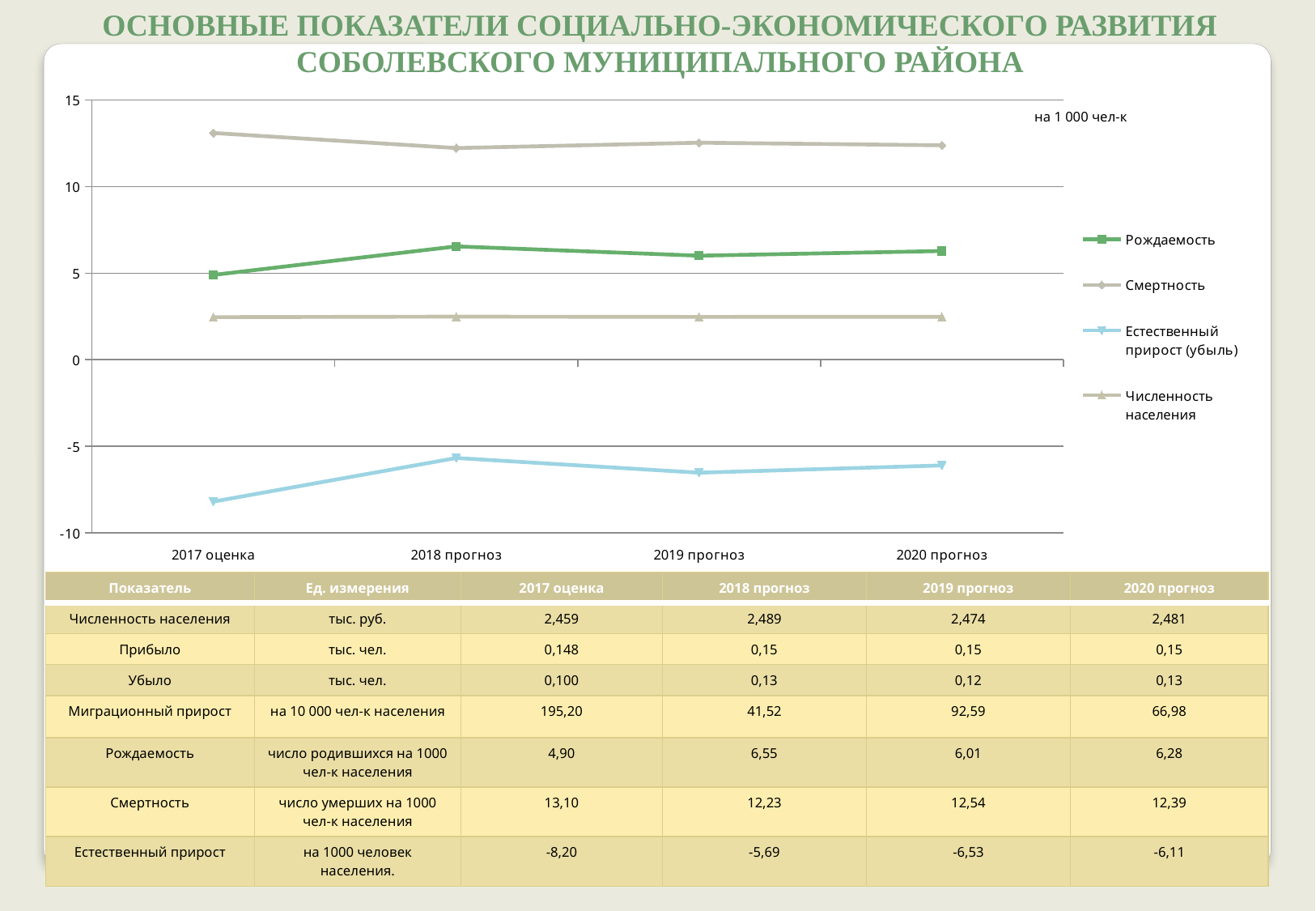
What is the value of Рождаемость for 2018 прогноз? 6,55 What is the difference between Смертность in 2017 оценка (13,10) and in 2018 прогноз (12,23)? 0,87 Does the Естественный прирост (убыль) line rise or fall from 2017 оценка to 2018 прогноз? rise Is the value for Смертность in 2017 оценка greater or less than 10? greater Which series has the highest values on the chart? Смертность What unit note is printed in the top right corner of the chart area? на 1 000 чел-к Which series has the lowest values on the chart? Естественный прирост (убыль) Is the value for Естественный прирост (убыль) in 2017 оценка greater or less than -5? less How many points along the x axis does the chart have? 4 Which is larger for Рождаемость: the value for 2018 прогноз or for 2019 прогноз? 2018 прогноз What kind of chart is shown on the slide? line chart How many series does the chart legend list? 4